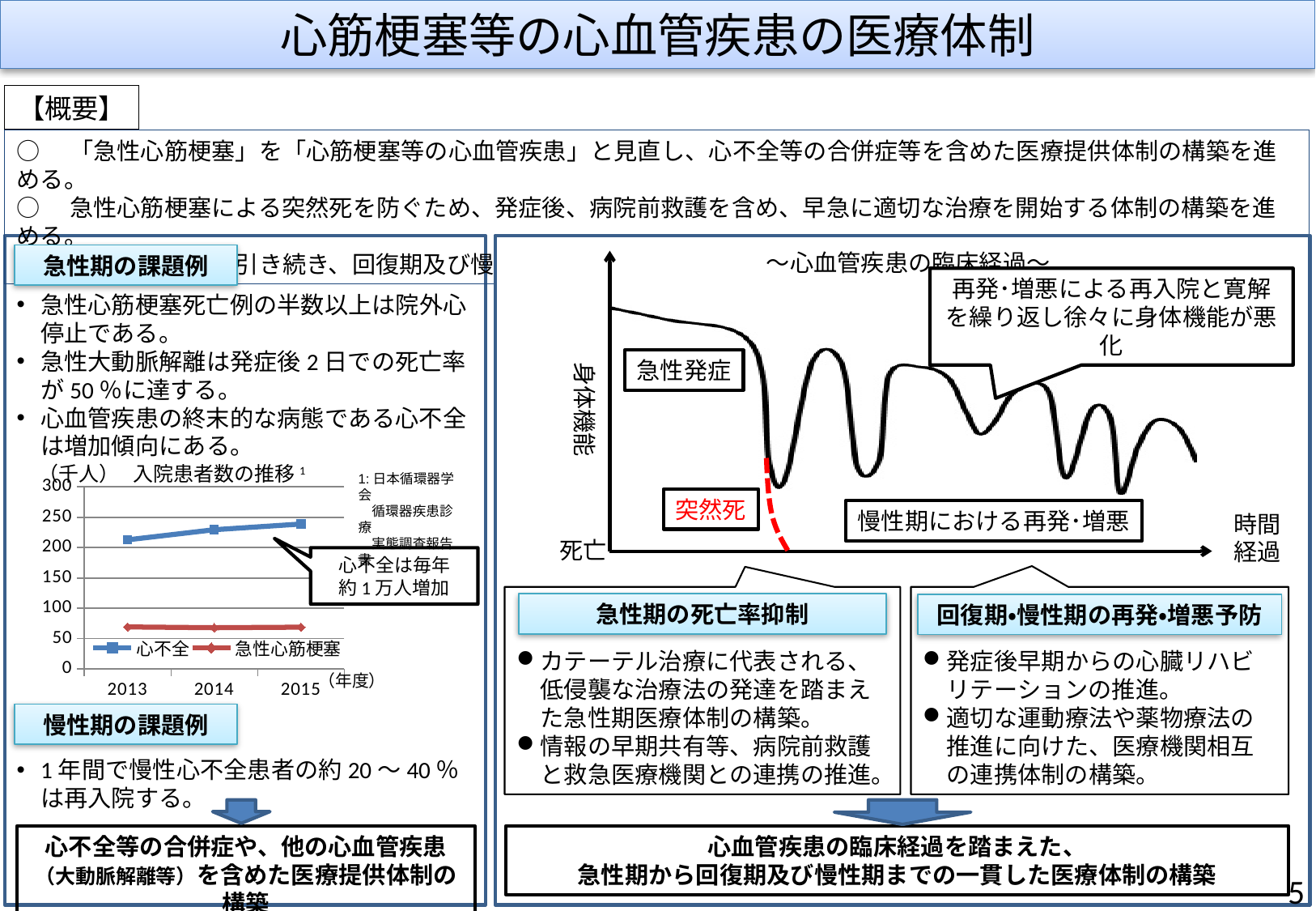
In the 入院患者数の推移 chart, is the value for 心不全 in 2015 greater or less than 150? greater In the 入院患者数の推移 chart, which year has the lowest value for 心不全? 2013 What unit is shown on the y axis of the 入院患者数の推移 chart? 千人 In the 入院患者数の推移 chart, is the value for 急性心筋梗塞 in 2014 greater or less than 100? less In the 入院患者数の推移 chart, which year has the highest value for 心不全? 2015 How many series does the legend of the 入院患者数の推移 chart list? 2 Which series are listed in the legend of the 入院患者数の推移 chart? 心不全 and 急性心筋梗塞 In the 入院患者数の推移 chart, which series has the larger value in 2015, 心不全 or 急性心筋梗塞? 心不全 In the 入院患者数の推移 chart, does the 心不全 series rise or fall from 2013 to 2015? rise How many years are plotted on the x axis of the 入院患者数の推移 chart? 3 In the 入院患者数の推移 chart, is the value for 心不全 in 2015 greater or less than 250? less What kind of chart is the 入院患者数の推移 chart on the left of the slide? line chart